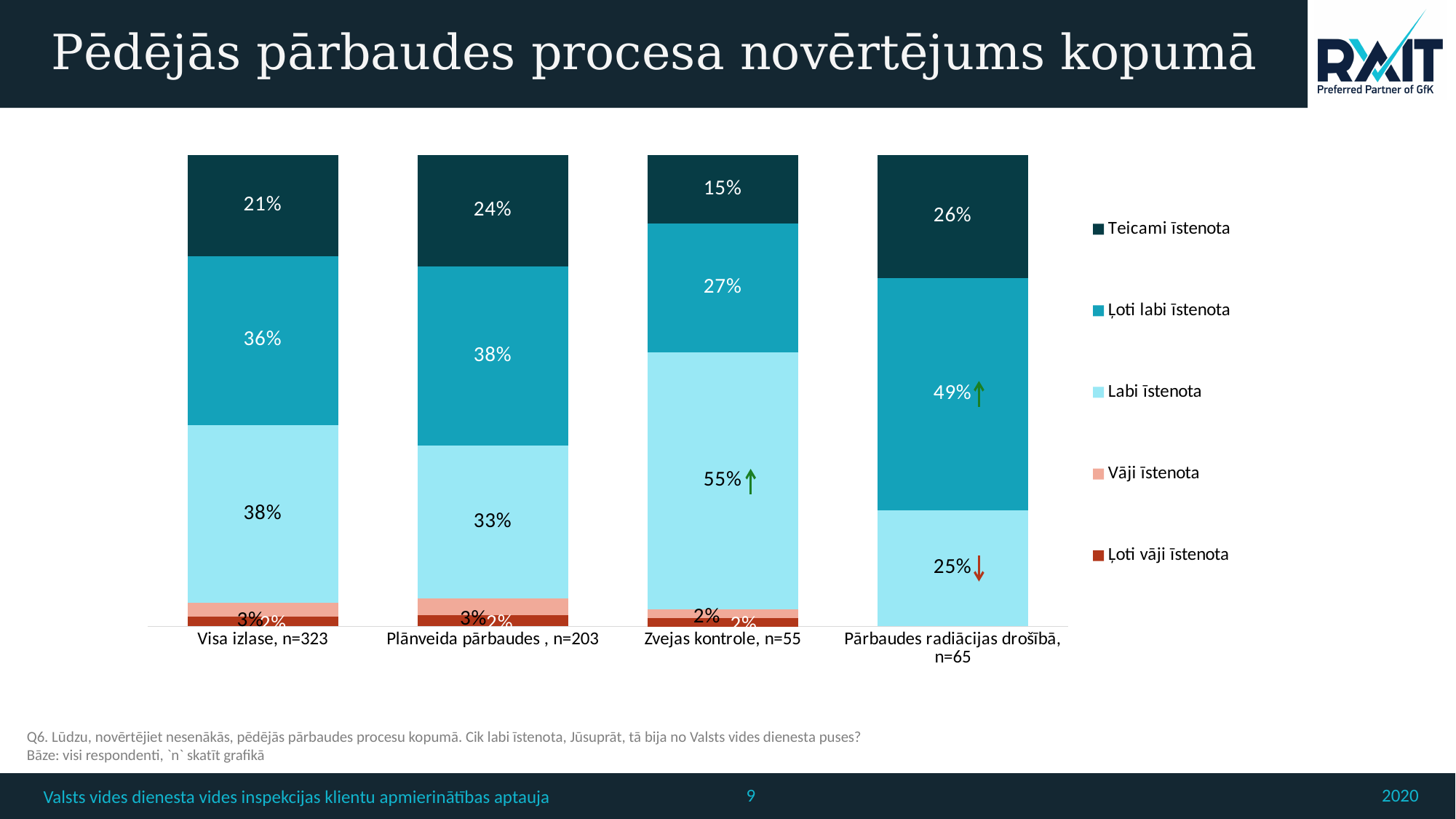
What is the value of "Teicami īstenota" for "Visa izlase, n=323"? 21% What is the value of "Ļoti labi īstenota" for "Pārbaudes radiācijas drošībā, n=65"? 49% Which is larger: "Teicami īstenota" for "Plānveida pārbaudes, n=203" or for "Zvejas kontrole, n=55"? Plānveida pārbaudes, n=203 Which category has the lowest value for "Labi īstenota"? Pārbaudes radiācijas drošībā, n=65 Which category has the highest value for "Teicami īstenota"? Pārbaudes radiācijas drošībā, n=65 What is the value of "Labi īstenota" for "Zvejas kontrole, n=55"? 55% How many series does the legend list? 5 What is the value of "Ļoti labi īstenota" for "Plānveida pārbaudes, n=203"? 38% How many categories (bars) are shown on the x axis? 4 Which legend entry is shown in the darkest colour? Teicami īstenota What kind of chart is shown on the slide? Stacked bar chart What is the difference between the "Labi īstenota" values for "Zvejas kontrole, n=55" and "Visa izlase, n=323"? 17%